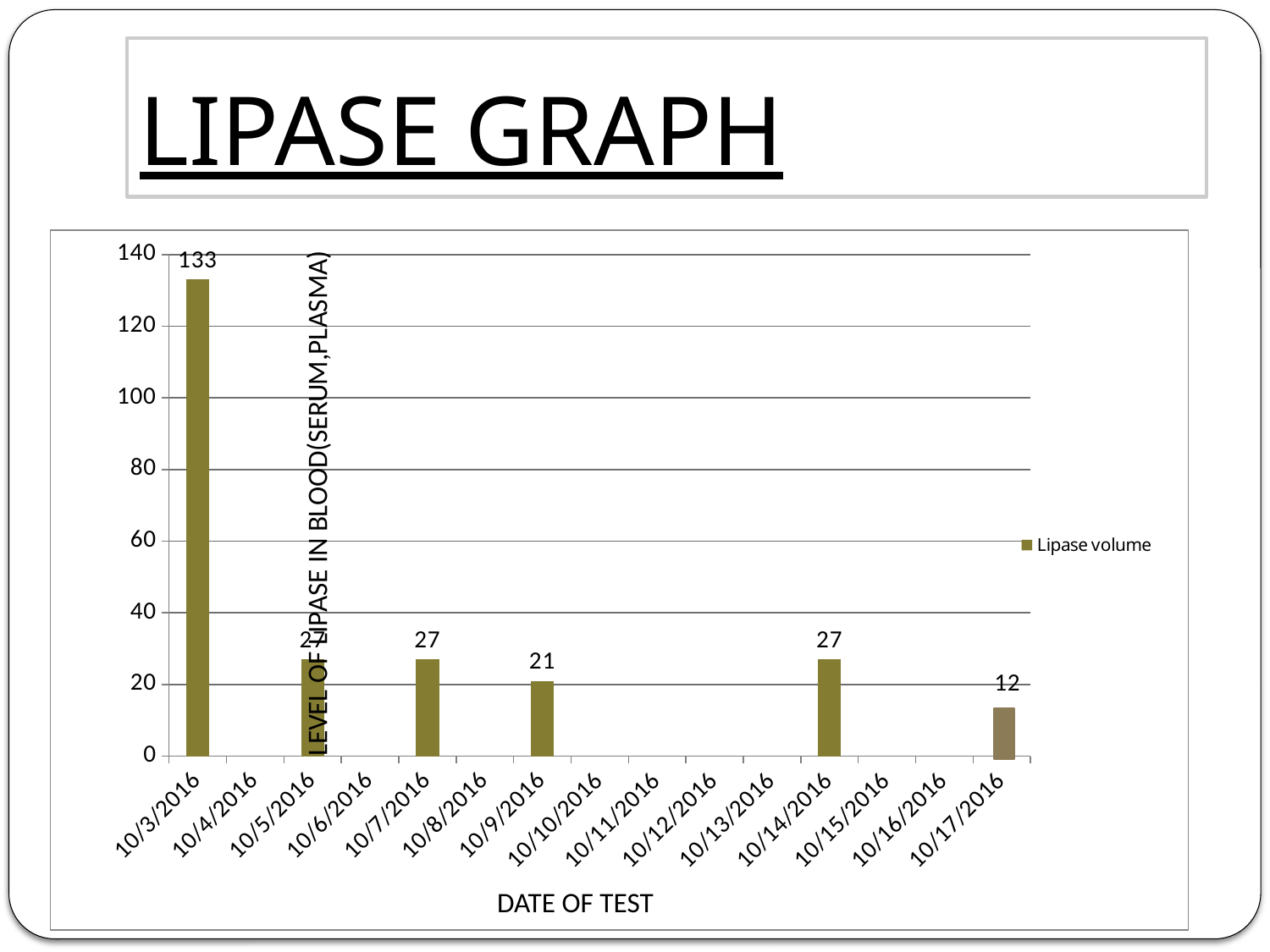
What is the Lipase volume on 10/9/2016? 21 Is the Lipase volume on 10/3/2016 greater or less than 120? greater What is the difference between the Lipase volume on 10/3/2016 and on 10/7/2016? 106 What is the Lipase volume on 10/14/2016? 27 How many bars are plotted in the chart? 6 What is the title of the x axis? DATE OF TEST Which is larger, the Lipase volume on 10/9/2016 or on 10/17/2016? 10/9/2016 What type of chart is shown on the slide? bar chart On which date is the Lipase volume lowest? 10/17/2016 What is the Lipase volume on 10/17/2016? 12 What is the Lipase volume on 10/3/2016? 133 On which date is the Lipase volume highest? 10/3/2016